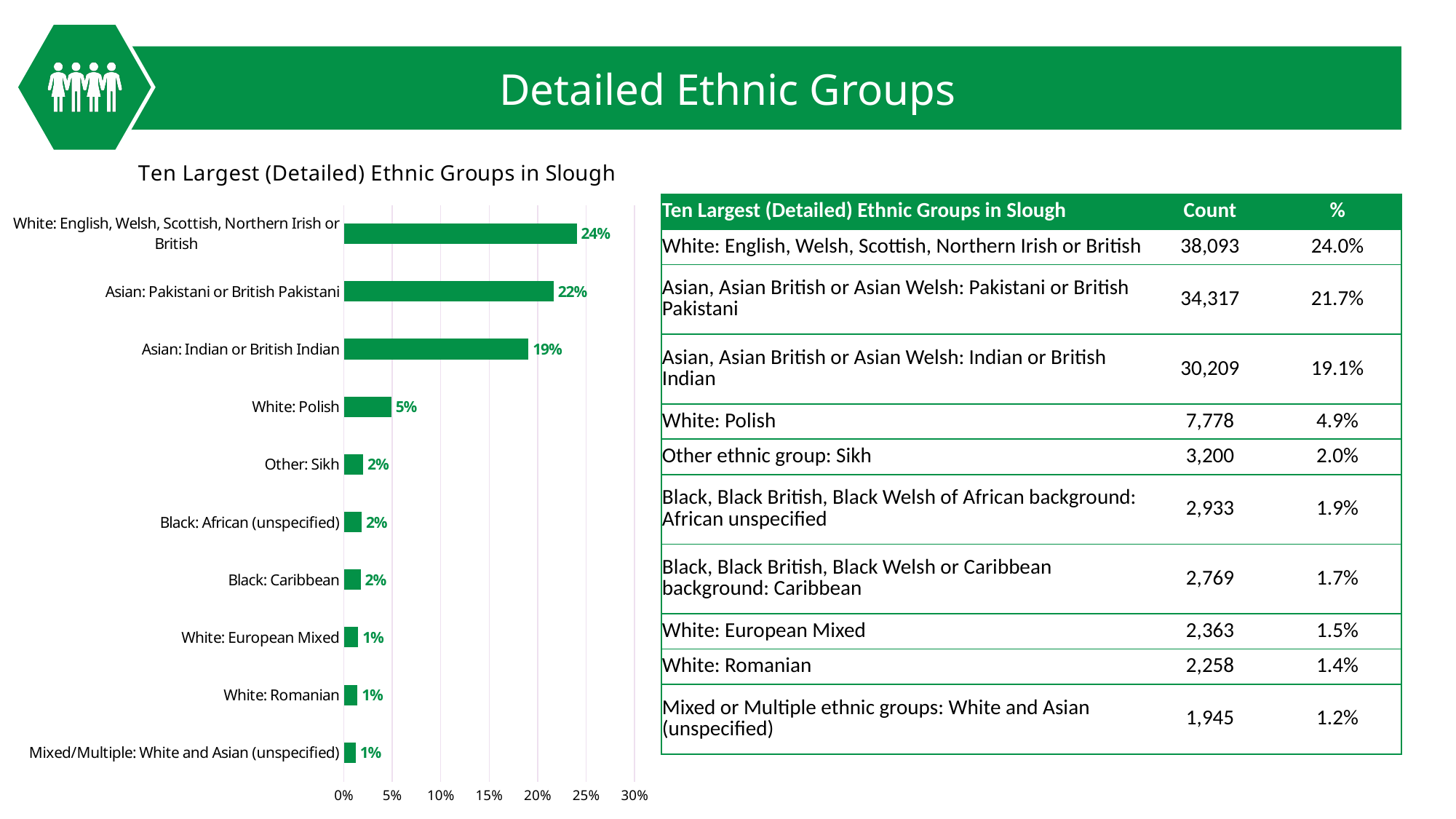
What is the title of the chart? Ten Largest (Detailed) Ethnic Groups in Slough Which category has the highest value in the chart? White: English, Welsh, Scottish, Northern Irish or British What is the difference between the values for White: English, Welsh, Scottish, Northern Irish or British and Asian: Pakistani or British Pakistani in the chart? 2% What is the value for White: Polish in the chart? 5% What is the value for Asian: Indian or British Indian in the chart? 19% What is the value for Asian: Pakistani or British Pakistani in the chart? 22% Which is larger in the chart, the value for Asian: Indian or British Indian or the value for White: Polish? Asian: Indian or British Indian Is the value for Asian: Pakistani or British Pakistani greater or less than 20%? greater Is the value for White: Polish greater or less than 10%? less What is the difference between the values for Asian: Indian or British Indian and White: Polish in the chart? 14% How many categories are shown in the chart? 10 What kind of chart is shown on the slide? bar chart